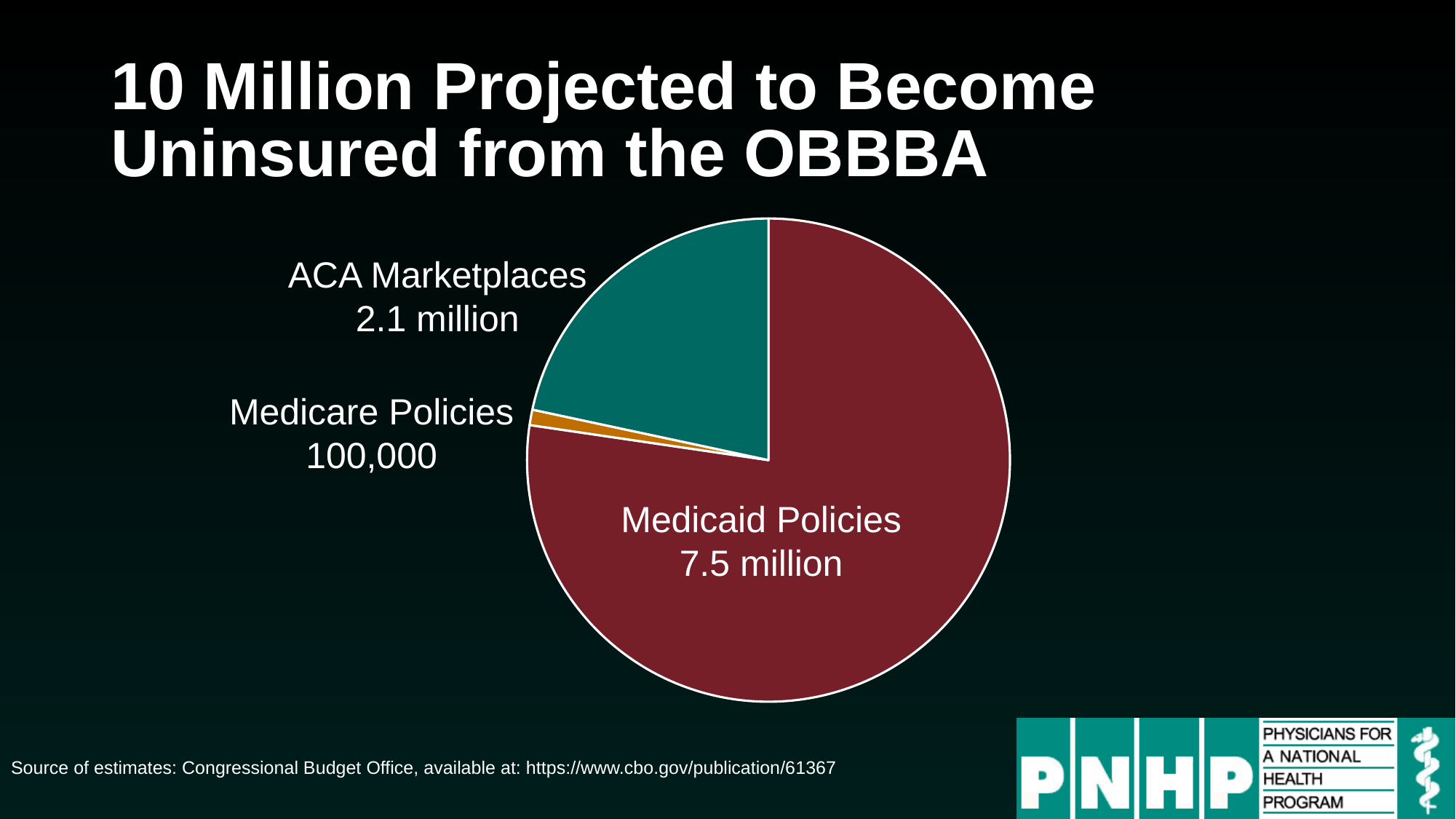
Which category has the largest slice of the pie? Medicaid Policies What is the value for Medicare Policies? 100,000 How many slices does the pie chart have? 3 What is the value for ACA Marketplaces? 2.1 million What is the title of the slide containing the pie chart? 10 Million Projected to Become Uninsured from the OBBBA What kind of chart is shown on the slide? pie chart Which category has the smallest slice of the pie? Medicare Policies Which is larger, the value for ACA Marketplaces or the value for Medicare Policies? ACA Marketplaces What is the difference between the Medicaid Policies value and the ACA Marketplaces value? 5.4 million What colour is the Medicaid Policies slice? dark red What is the value for Medicaid Policies? 7.5 million What is the difference between the ACA Marketplaces value and the Medicare Policies value? 2 million